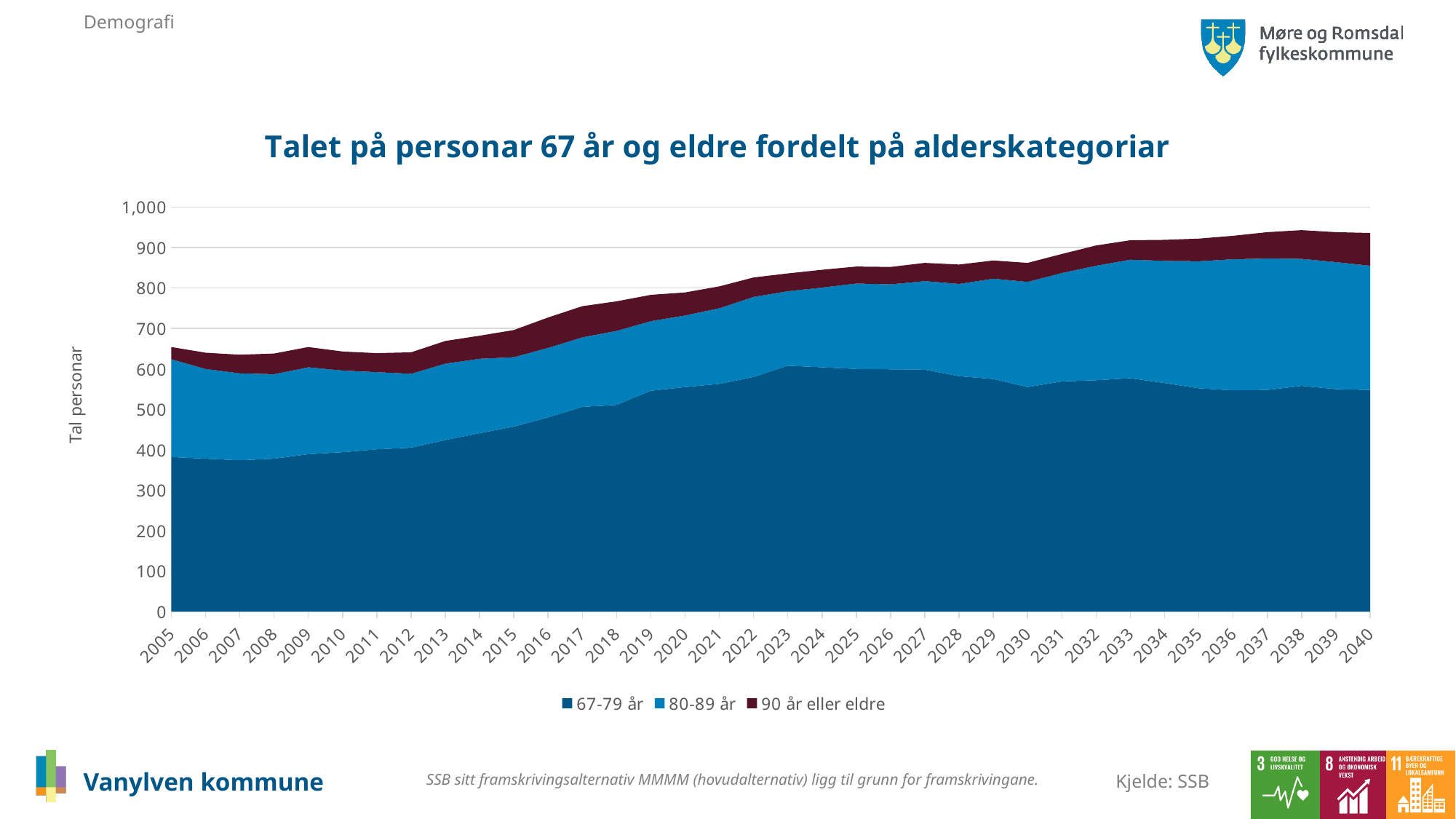
What is the first year shown on the x axis? 2005 Which age categories are listed in the legend? 67-79 år, 80-89 år, 90 år eller eldre Is the value for 67-79 år in 2005 greater or less than 400? less Is the value for 67-79 år in 2040 greater or less than 500? greater Is the total number of persons 67 år og eldre in 2040 greater or less than 900? greater Does the total number of persons 67 år og eldre rise or fall from 2005 to 2040? rise How many series does the legend list? 3 What is the title of the chart? Talet på personar 67 år og eldre fordelt på alderskategoriar How many years are shown along the x axis? 36 What is the last year shown on the x axis? 2040 What kind of chart is shown on the slide? Stacked area chart